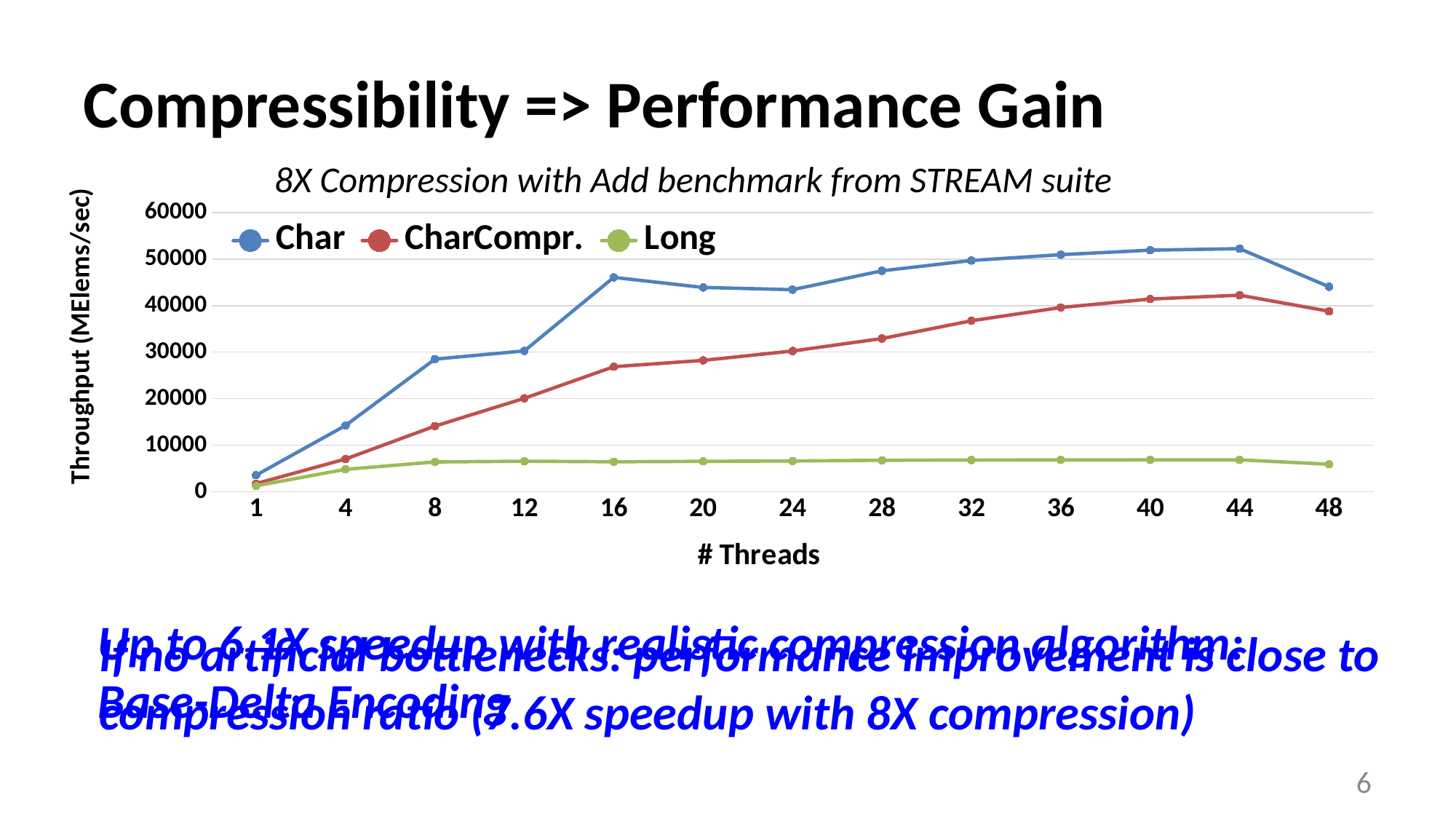
At 24 threads, which series has the higher throughput, Char or CharCompr.? Char What kind of chart is shown on the slide? line chart What is the label of the y axis? Throughput (MElems/sec) Is the Long throughput at 48 threads greater or less than 10000? less What is the title of the chart? 8X Compression with Add benchmark from STREAM suite How many series does the chart legend list? 3 How many thread counts are plotted along the x axis? 13 Which series has the lowest throughput at 32 threads? Long Is the Char throughput at 16 threads greater or less than 40000? greater Is the CharCompr. throughput at 8 threads greater or less than 20000? less Does the Char throughput rise or fall as the thread count goes from 1 to 16? rises